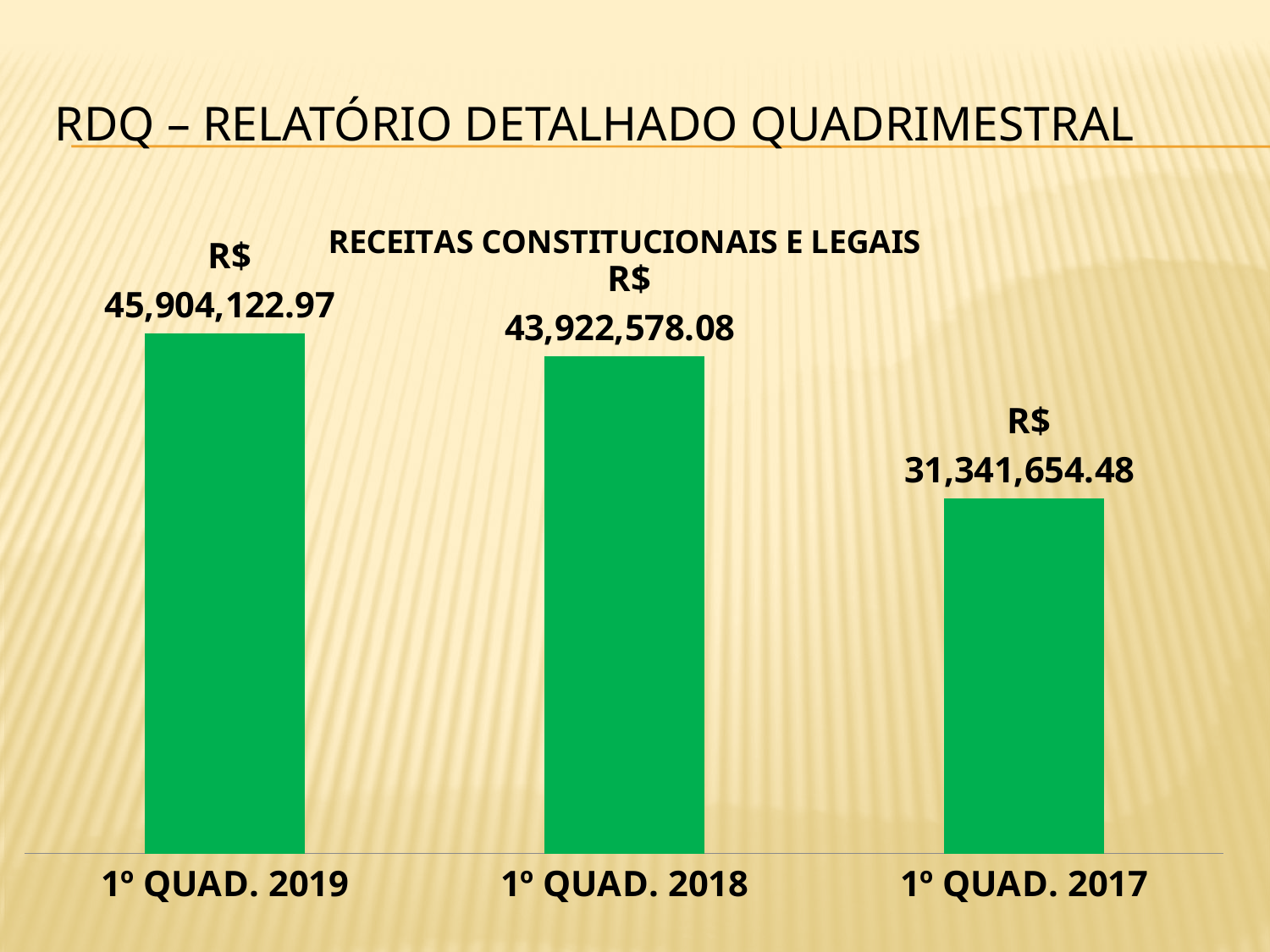
What is the value for 1º QUAD. 2018? R$ 43,922,578.08 What is the title of the chart? RECEITAS CONSTITUCIONAIS E LEGAIS What is the difference between the values for 1º QUAD. 2019 and 1º QUAD. 2017? R$ 14,562,468.49 Which is larger, the value for 1º QUAD. 2018 or 1º QUAD. 2017? 1º QUAD. 2018 What kind of chart is shown on the slide? Bar chart How many categories are shown in the chart? 3 What is the value for 1º QUAD. 2017? R$ 31,341,654.48 What is the difference between the values for 1º QUAD. 2018 and 1º QUAD. 2017? R$ 12,580,923.60 Which category has the lowest value? 1º QUAD. 2017 Which category has the highest value? 1º QUAD. 2019 What is the difference between the values for 1º QUAD. 2019 and 1º QUAD. 2018? R$ 1,981,544.89 What is the value for 1º QUAD. 2019? R$ 45,904,122.97